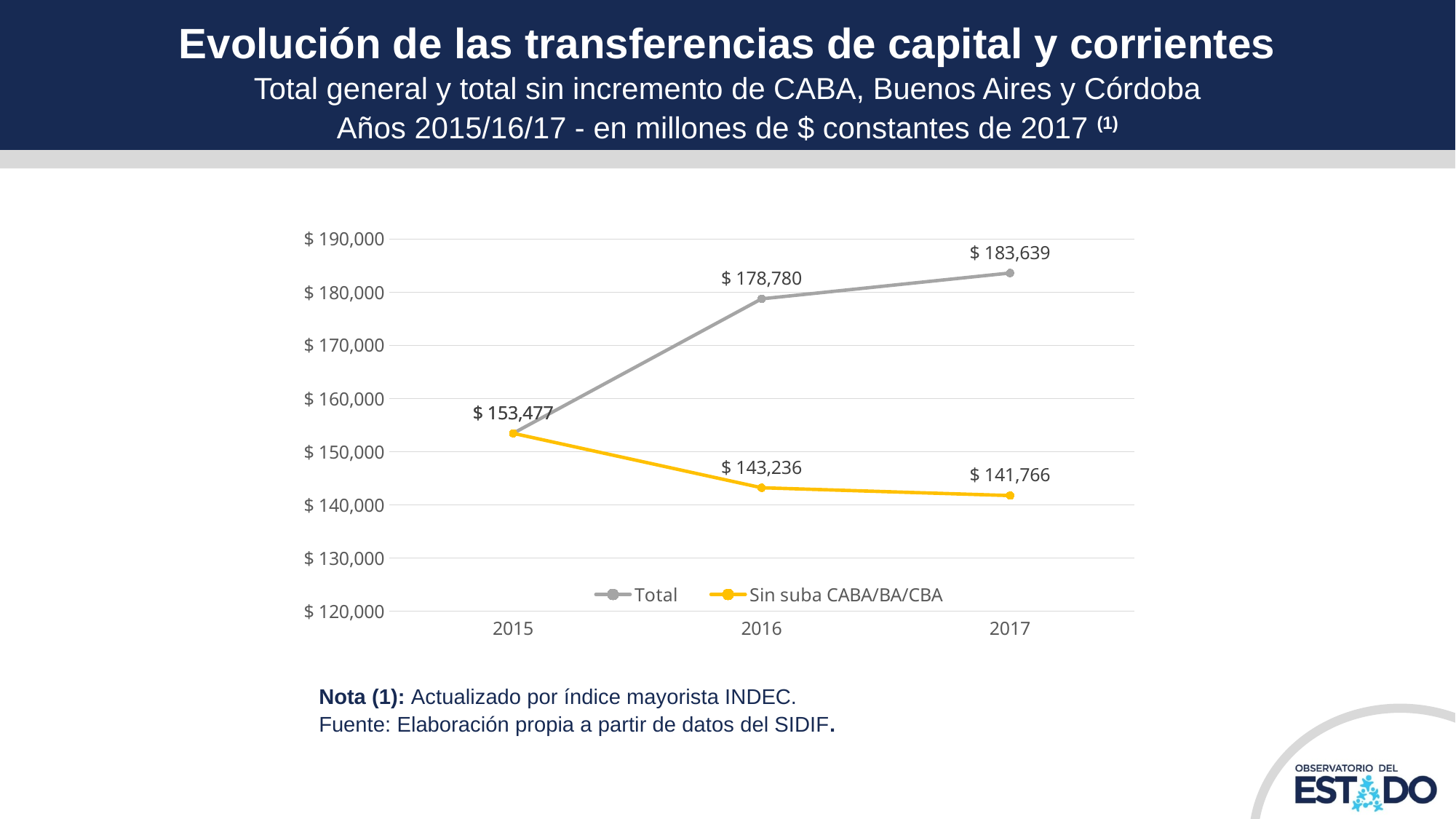
What is the difference between the Total and Sin suba CABA/BA/CBA values in 2017? $ 41,873 How many series does the legend list? 2 What is the value shared by both series in 2015? $ 153,477 What is the value of the Sin suba CABA/BA/CBA series in 2017? $ 141,766 What kind of chart is shown on the slide? line chart How many years are shown on the x axis? 3 In which year is the Total series highest? 2017 What is the value of the Total series in 2016? $ 178,780 Is the Total value for 2017 greater or less than $ 180,000? greater In which year is the Sin suba CABA/BA/CBA series lowest? 2017 Which series has the larger value in 2016, Total or Sin suba CABA/BA/CBA? Total Does the Sin suba CABA/BA/CBA series rise or fall from 2015 to 2017? fall